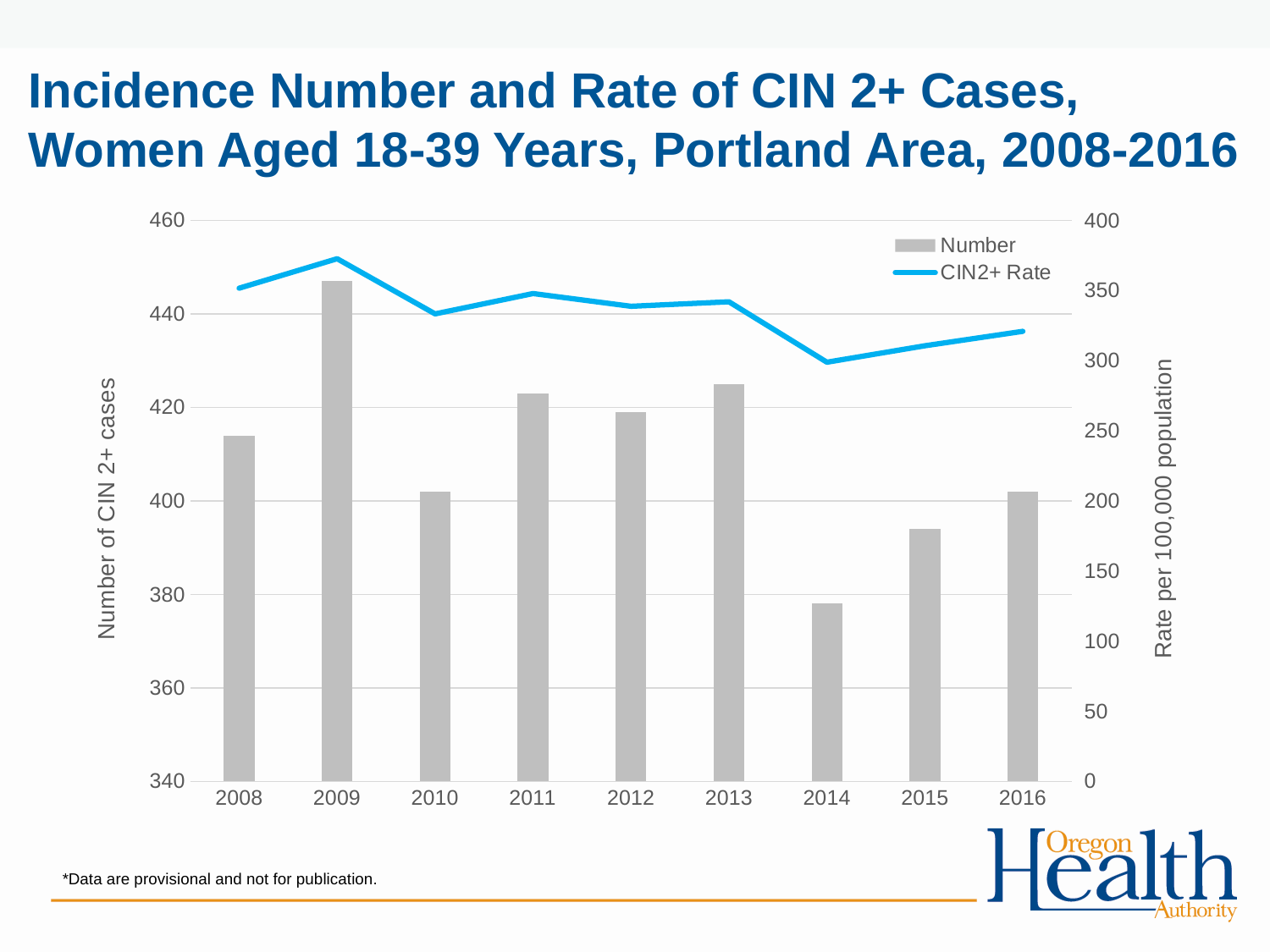
What kind of chart is shown on the slide? A combined bar and line chart Which year has the highest Number of CIN 2+ cases? 2009 How many years are shown on the x axis? 9 How many series does the legend list? 2 Does the CIN2+ Rate rise or fall from 2014 to 2016? rise Which year has a larger Number of CIN 2+ cases, 2011 or 2015? 2011 Is the CIN2+ Rate for 2009 greater or less than 350? greater Is the Number of CIN 2+ cases for 2009 greater or less than 440? greater Which year has the highest CIN2+ Rate? 2009 Which year has the lowest Number of CIN 2+ cases? 2014 Is the Number of CIN 2+ cases for 2015 greater or less than 400? less Which year has the lowest CIN2+ Rate? 2014